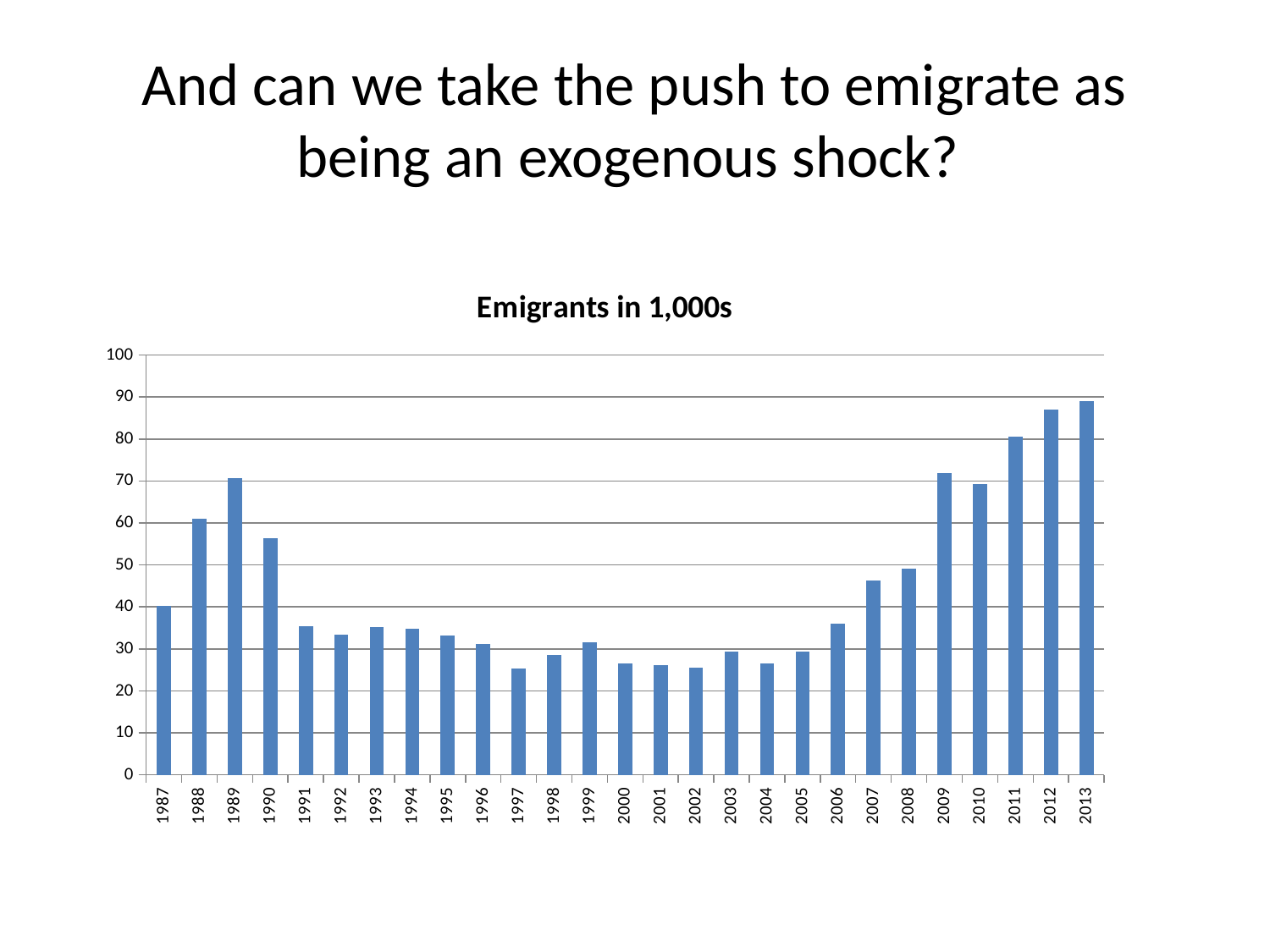
Is the value for 1990 greater or less than 50? greater Which year has the larger value, 1990 or 2006? 1990 Is the value for 2007 greater or less than 50? less How many years are plotted on the x axis of the chart? 27 Is the value for 2006 greater or less than 30? greater Which year has the larger value, 1988 or 1989? 1989 What is the title of the chart? Emigrants in 1,000s Do the values rise or fall from 2005 to 2013? Rise Do the values rise or fall from 1989 to 1997? Fall What kind of chart is shown on the slide? Bar chart